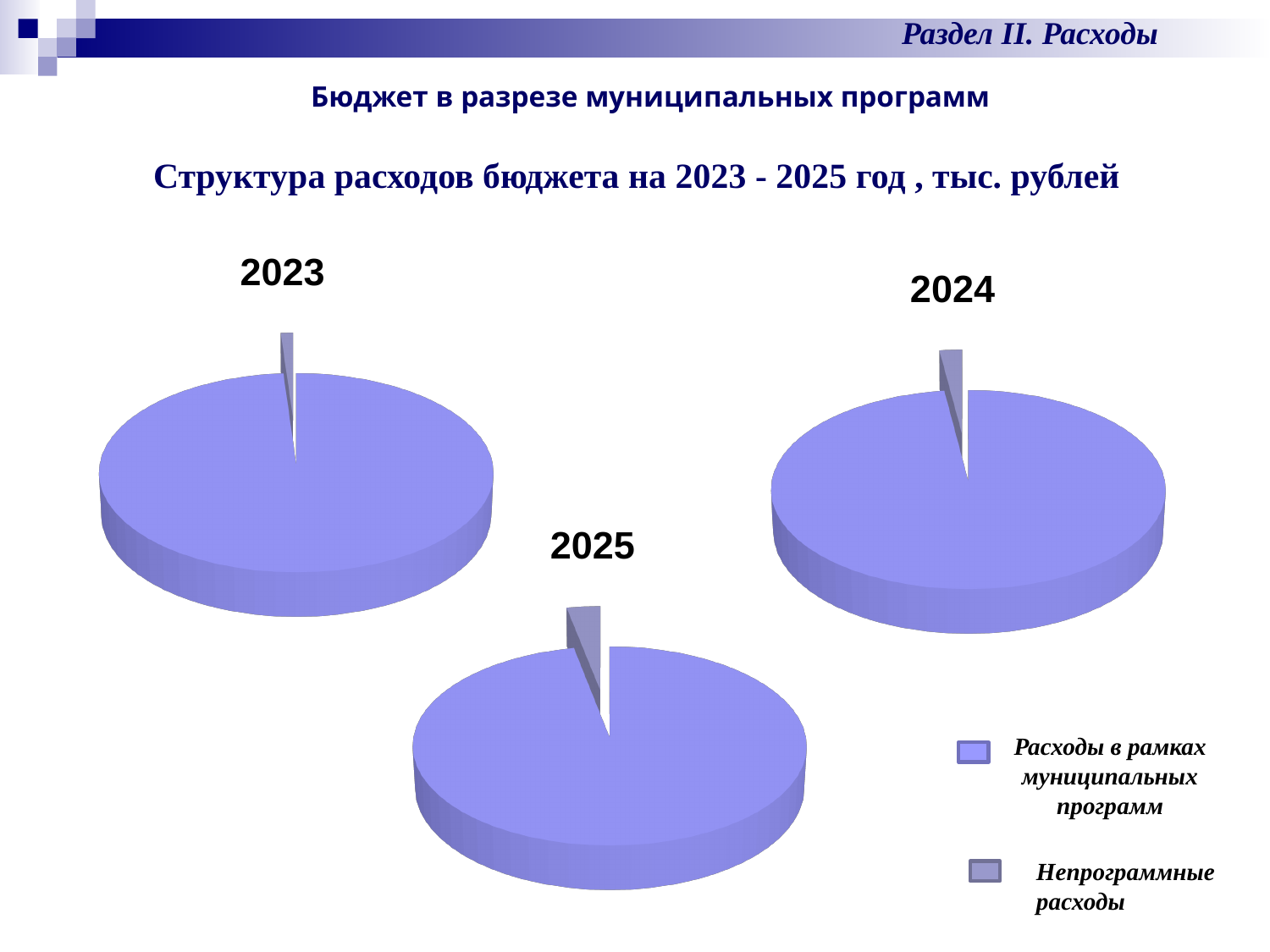
How many pie charts are shown on the slide? 3 What kind of chart is the 2023 chart? pie chart In the 2025 pie chart, which is larger: Расходы в рамках муниципальных программ or Непрограммные расходы? Расходы в рамках муниципальных программ What is the title shown above the three pie charts? Структура расходов бюджета на 2023 - 2025 год , тыс. рублей How many slices does the 2024 pie chart have? 2 In the 2024 pie chart, which category has the smallest share? Непрограммные расходы What kind of chart is the 2025 chart? pie chart In the 2023 pie chart, which category has the largest share? Расходы в рамках муниципальных программ How many categories does the legend list? 2 In the 2023 pie chart, which is smaller: Расходы в рамках муниципальных программ or Непрограммные расходы? Непрограммные расходы Which years are the three pie charts labelled with? 2023, 2024, 2025